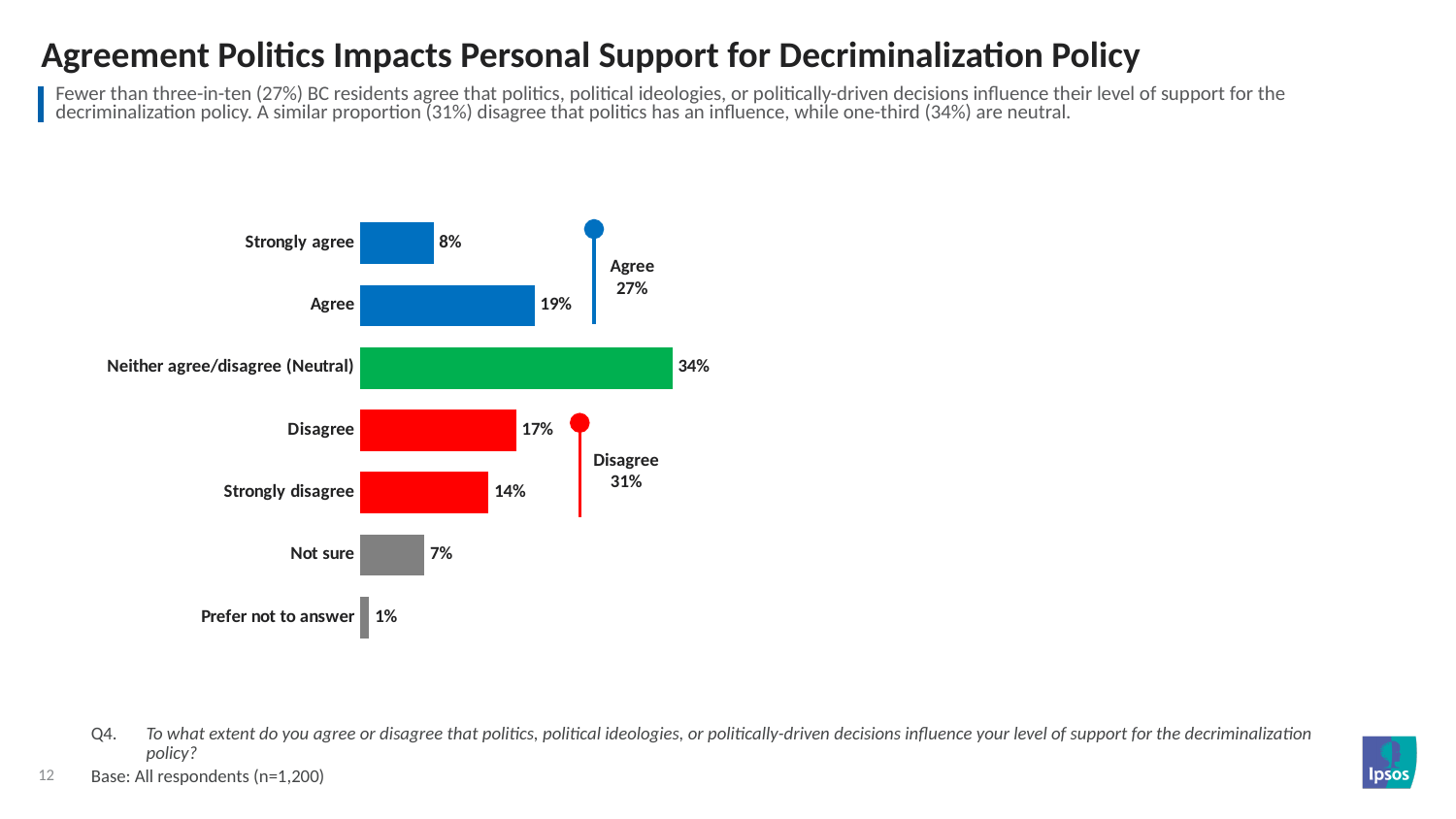
How many categories are shown in the chart? 7 Which category has the highest value? Neither agree/disagree (Neutral) Which category has the lowest value? Prefer not to answer What percentage of respondents chose 'Prefer not to answer'? 1% What percentage of respondents selected 'Neither agree/disagree (Neutral)'? 34% What is the combined total for 'Strongly agree' and 'Agree' as labelled on the chart? 27% What is the value for 'Strongly agree'? 8% What is the combined 'Disagree' total shown on the chart? 31% What is the value shown for 'Not sure'? 7% What type of chart is shown on the slide? Bar chart What is the difference between the 'Agree' and 'Strongly agree' values? 11% Which is larger, the value for 'Disagree' or the value for 'Strongly disagree'? Disagree